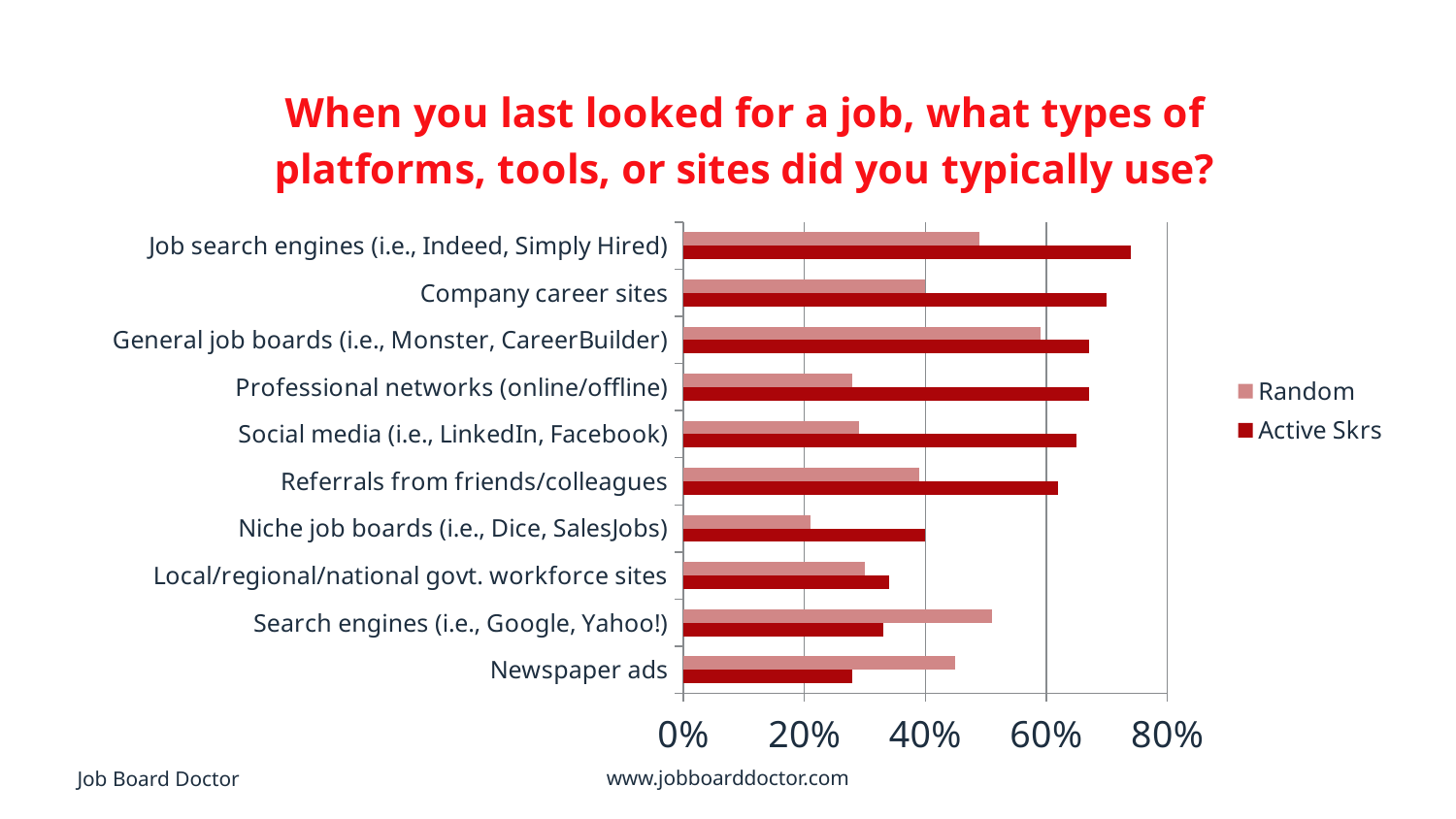
What are the two series named in the legend? Random and Active Skrs Which category has the highest value for Active Skrs? Job search engines (i.e., Indeed, Simply Hired) For Professional networks (online/offline), which series has the larger value, Random or Active Skrs? Active Skrs How many categories are plotted on the chart? 10 Is the Active Skrs value for Job search engines (i.e., Indeed, Simply Hired) greater or less than 60%? greater Which category has the lowest value for Random? Niche job boards (i.e., Dice, SalesJobs) For Search engines (i.e., Google, Yahoo!), which series has the larger value, Random or Active Skrs? Random Which category has the highest value for Random? General job boards (i.e., Monster, CareerBuilder) How many series does the legend list? 2 Is the Random value for Niche job boards (i.e., Dice, SalesJobs) greater or less than 40%? less Which category has the lowest value for Active Skrs? Newspaper ads What kind of chart is shown on the slide? bar chart